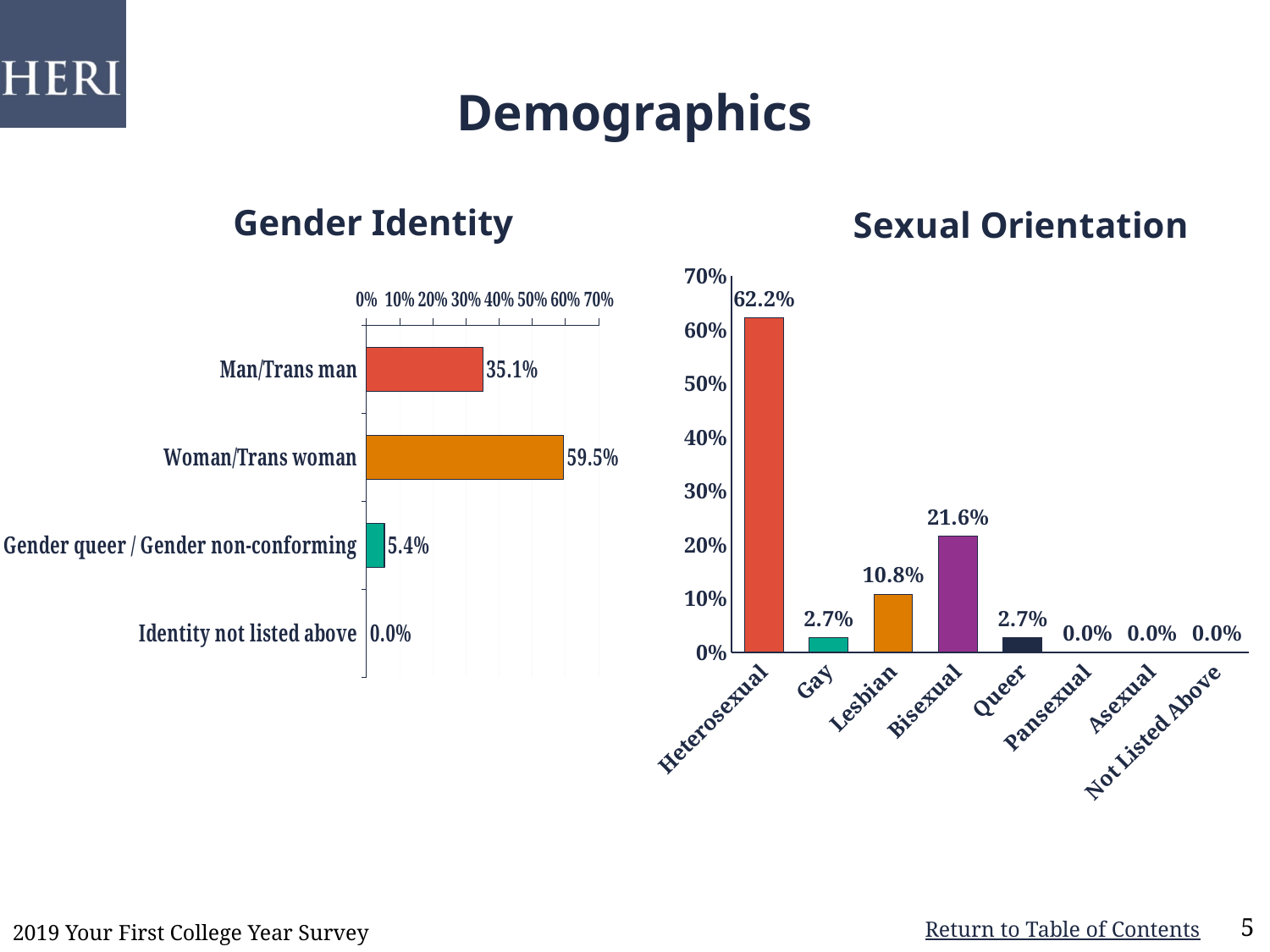
In the Sexual Orientation chart, which is larger, Bisexual or Lesbian? Bisexual In the Sexual Orientation chart, what is the difference between Heterosexual and Bisexual? 40.6% In the Gender Identity chart, what is the value for Gender queer / Gender non-conforming? 5.4% In the Gender Identity chart, how many categories are shown? 4 What kind of chart is the Gender Identity chart? Bar chart In the Gender Identity chart, which category has the highest value? Woman/Trans woman In the Sexual Orientation chart, which category has the highest value? Heterosexual In the Sexual Orientation chart, how many categories are shown on the x axis? 8 In the Sexual Orientation chart, what is the value for Lesbian? 10.8% In the Gender Identity chart, what is the difference between Woman/Trans woman and Man/Trans man? 24.4% In the Gender Identity chart, what is the value for Woman/Trans woman? 59.5% In the Sexual Orientation chart, what is the value for Bisexual? 21.6%